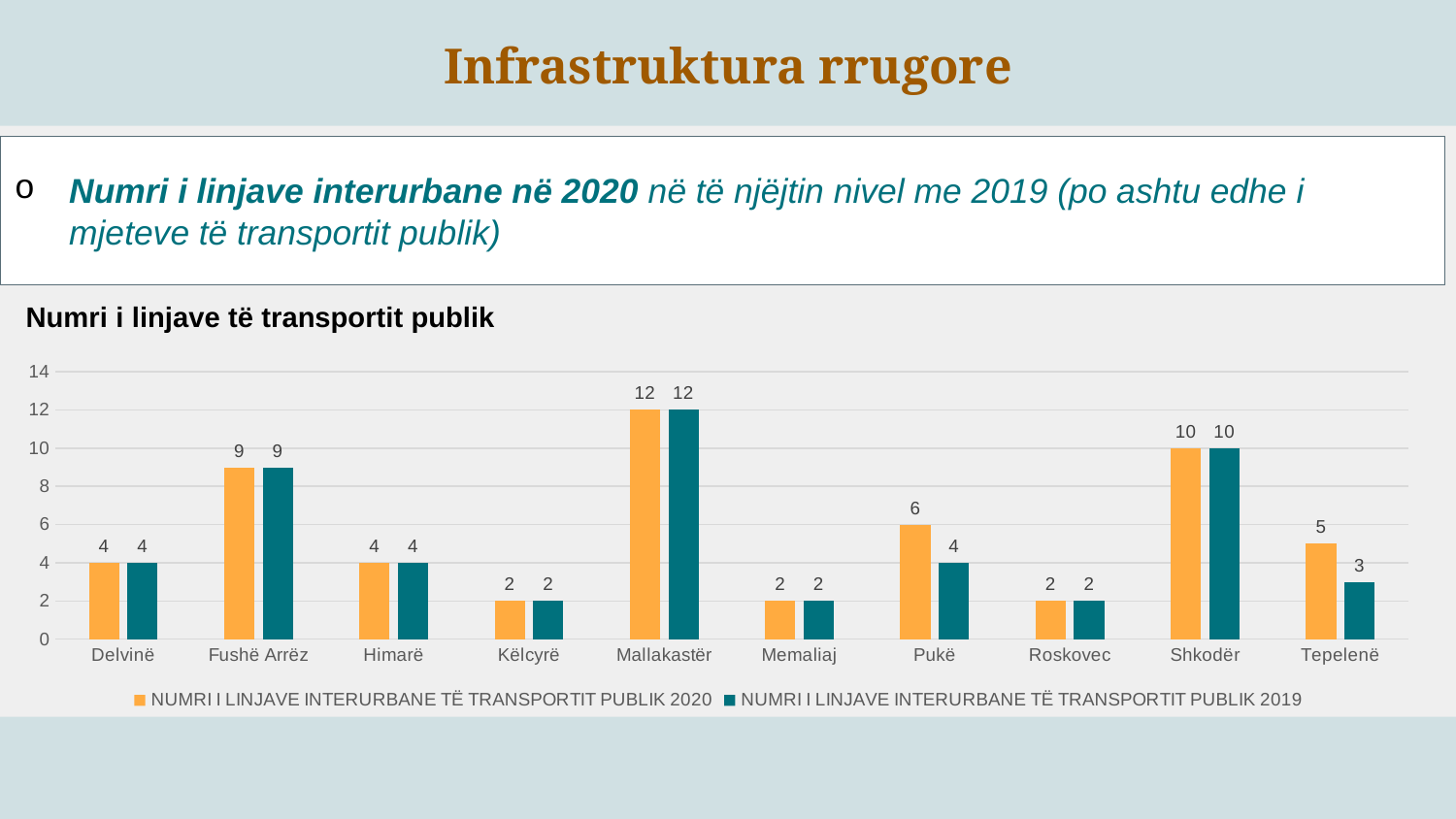
Which municipality has the highest value in the 2020 series? Mallakastër Which municipality has the lowest value in the 2019 series? Këlcyrë, Memaliaj and Roskovec (tied at 2) What is the value for Pukë in the 2019 series? 4 What is the difference between the 2020 and 2019 values for Pukë? 2 How many municipalities are shown on the x axis? 10 What is the value for Mallakastër in the 2020 series? 12 What is the title of the chart? Numri i linjave të transportit publik Which is larger for Tepelenë, the 2020 value or the 2019 value? 2020 How many series does the legend list? 2 What kind of chart is shown? bar chart Is the value for Shkodër in the 2020 series greater or less than 8? greater What is the value for Tepelenë in the 2020 series? 5